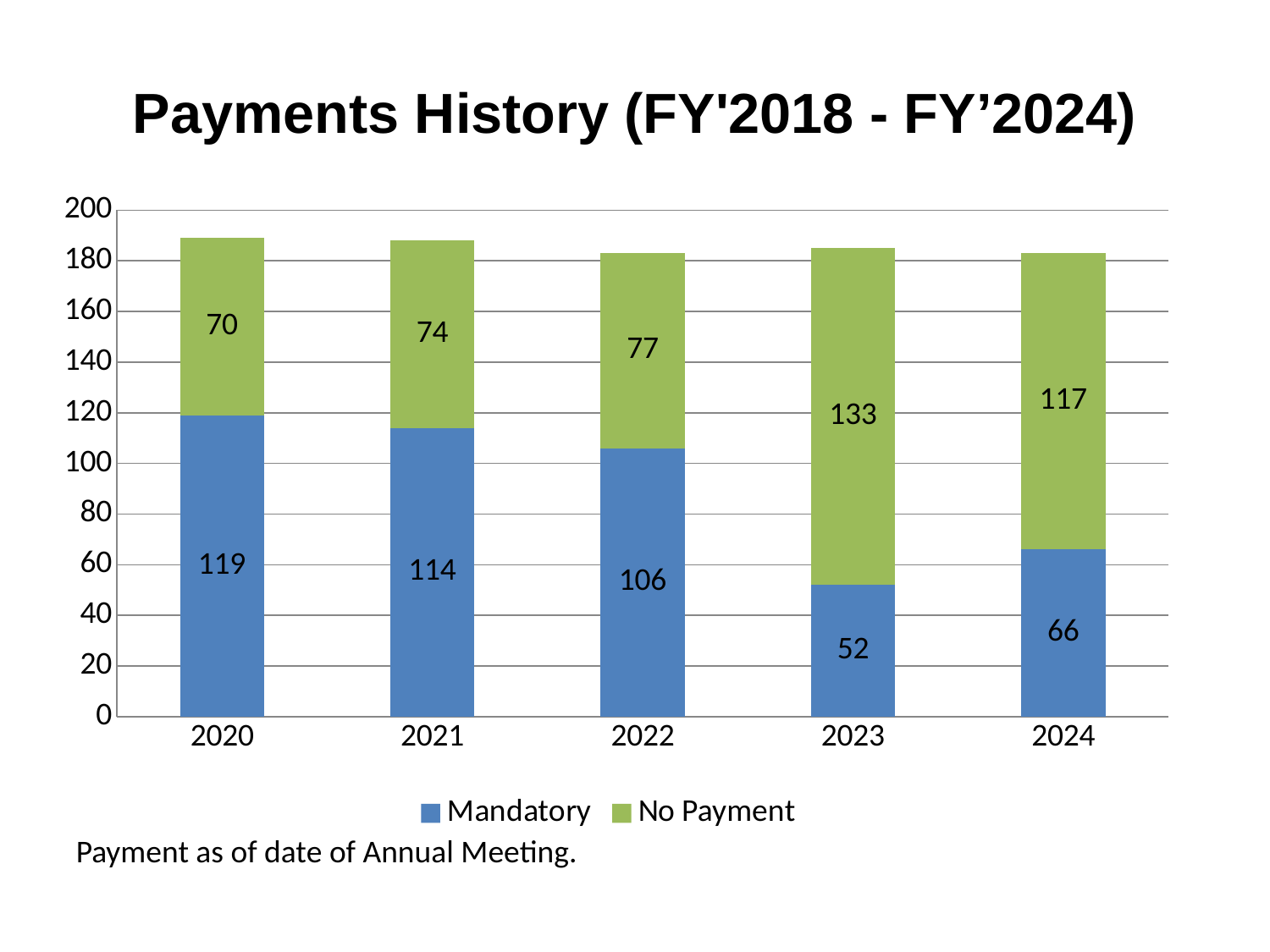
What is the Mandatory value for 2020? 119 What kind of chart is shown on the slide? Stacked bar chart What is the Mandatory value for 2024? 66 Which is larger, the No Payment value for 2022 or the No Payment value for 2024? 2024 How many years are shown on the x axis? 5 Which year has the lowest Mandatory value? 2023 What is the difference between the Mandatory values for 2020 and 2023? 67 How many series does the legend list? 2 What is the total of the stacked bar for 2021? 188 What is the No Payment value for 2023? 133 Which year has the highest No Payment value? 2023 Which year has the highest Mandatory value? 2020